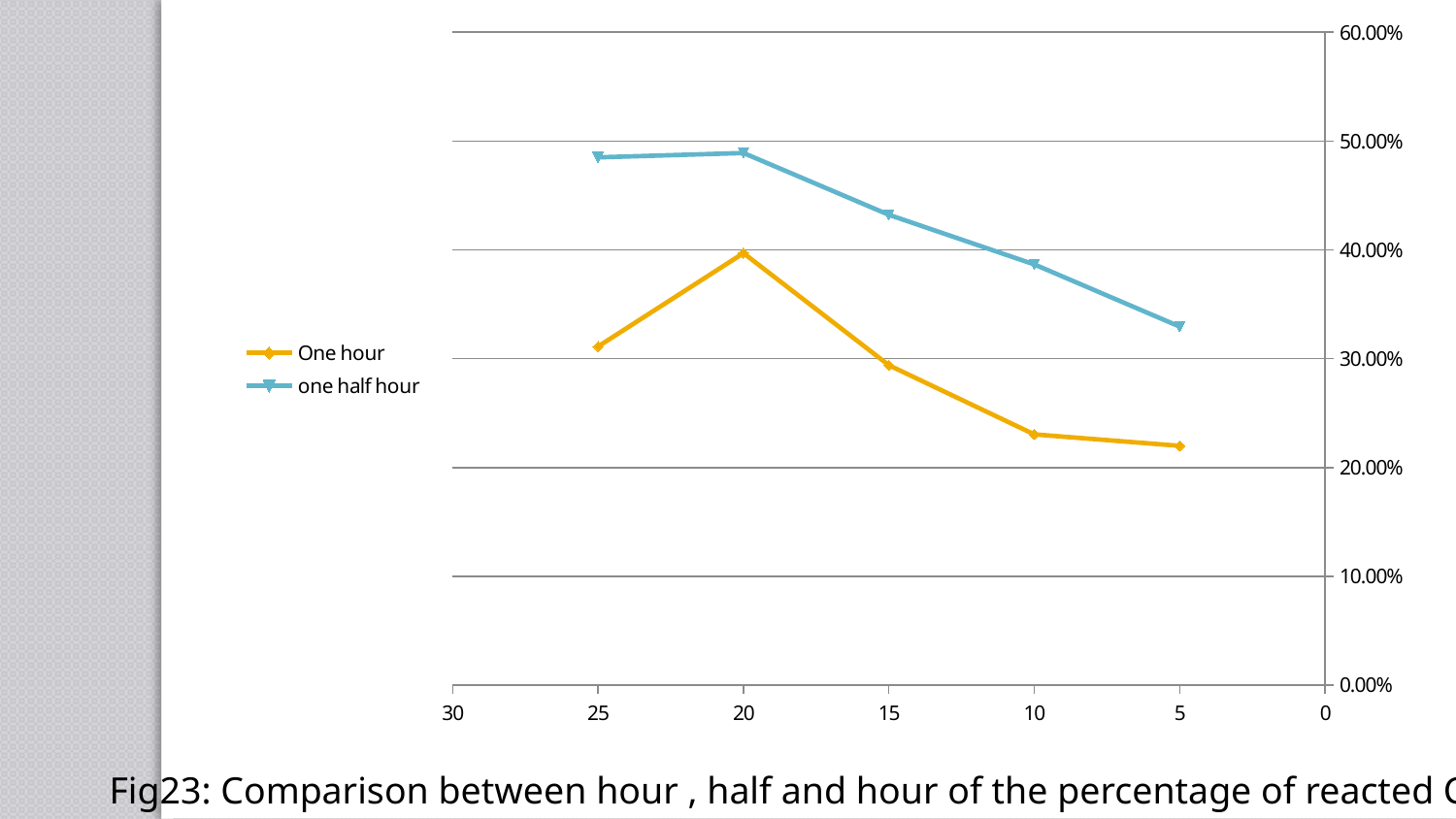
What colour is the line for the One hour series? orange How many series does the legend list? 2 How many data points are plotted for the One hour series? 5 Is the value for one half hour at x = 5 greater or less than 30.00%? greater What are the two series named in the legend? One hour and one half hour Does the one half hour series rise or fall moving from left to right along the x axis? fall What kind of chart is shown on the slide? line chart Is the value for one half hour at x = 20 greater or less than 40.00%? greater At which x-axis value does the one half hour series reach its lowest point? 5 At which x-axis value does the One hour series reach its highest point? 20 Is the value for One hour at x = 10 greater or less than 30.00%? less Which series has the larger value at x = 15, One hour or one half hour? one half hour